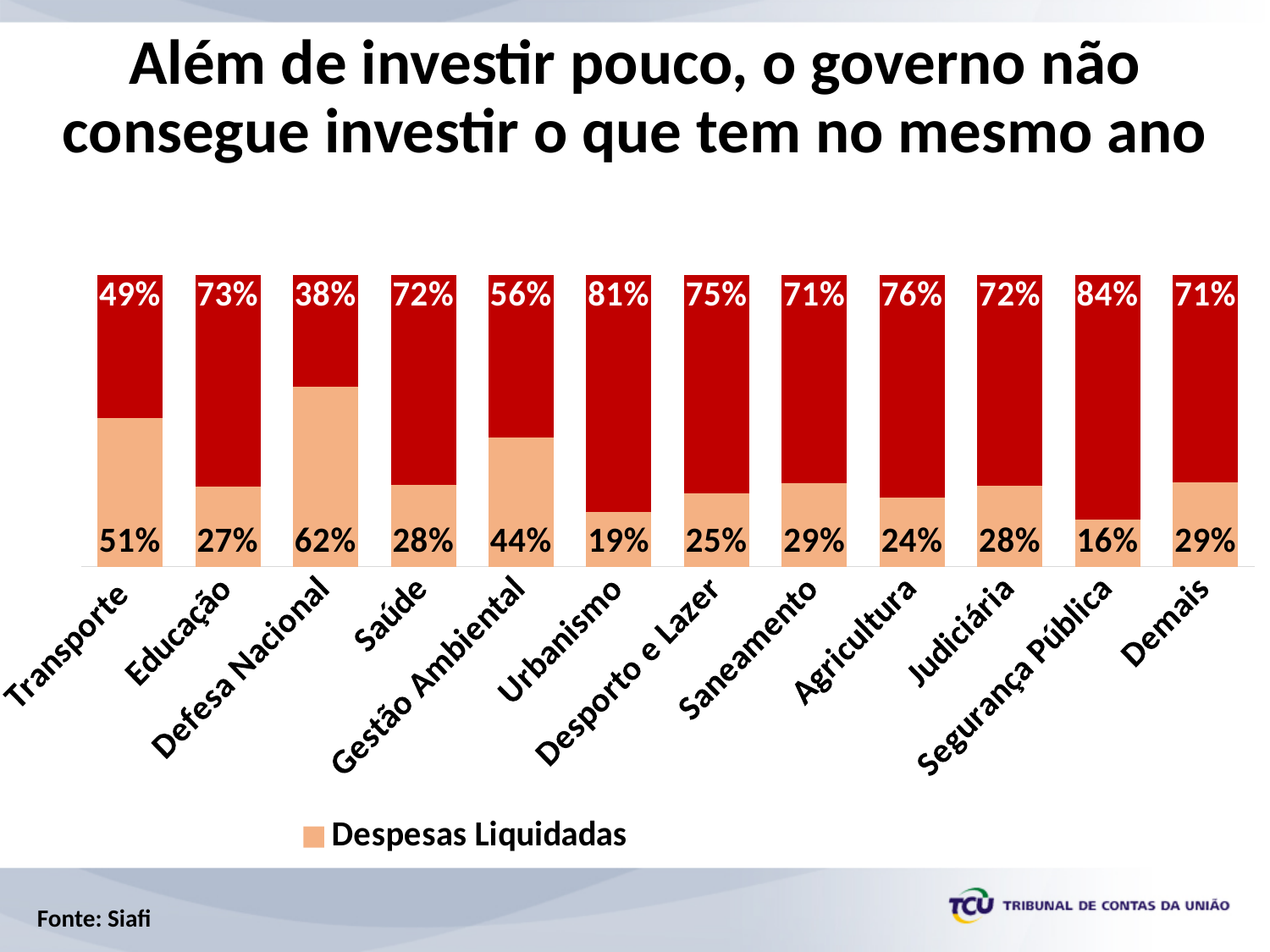
Which has a larger Despesas Liquidadas value, Transporte or Saúde? Transporte What value is printed on the red segment of the Urbanismo bar? 81% What value is printed on the red segment of the Segurança Pública bar? 84% How many categories are shown on the x axis? 12 What kind of chart is shown on the slide? Stacked bar chart What is the Despesas Liquidadas value for Transporte? 51% What is the difference between the Despesas Liquidadas values for Defesa Nacional and Educação? 35 percentage points What is the Despesas Liquidadas value for Gestão Ambiental? 44% Which category has the lowest Despesas Liquidadas value? Segurança Pública Which category has the highest Despesas Liquidadas value? Defesa Nacional What is the series name shown in the legend? Despesas Liquidadas How many series does the legend list? 1